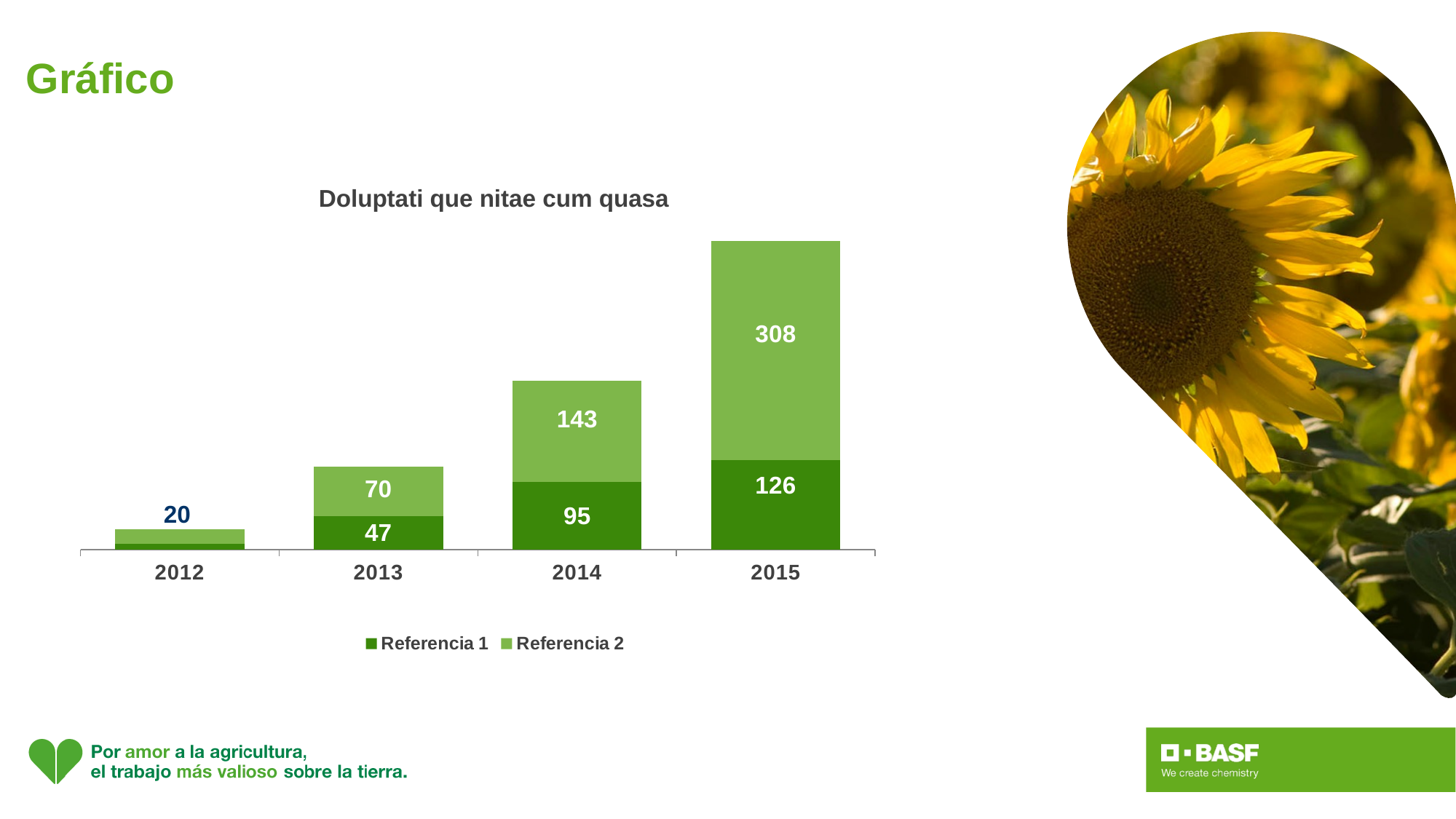
What is the value of Referencia 2 for 2015? 308 Which is larger, Referencia 1 for 2015 or Referencia 2 for 2014? Referencia 2 for 2014 What is the total of the stacked bar for 2015? 434 What is the difference between the Referencia 2 values for 2015 and 2014? 165 What is the value of Referencia 2 for 2014? 143 What is the value of Referencia 1 for 2014? 95 What is the value of Referencia 1 for 2013? 47 Which year has the highest value for Referencia 2? 2015 How many years are shown on the x axis? 4 Which year has the lowest value for Referencia 1? 2012 What kind of chart is shown on the slide? Stacked bar chart How many series does the legend list? 2